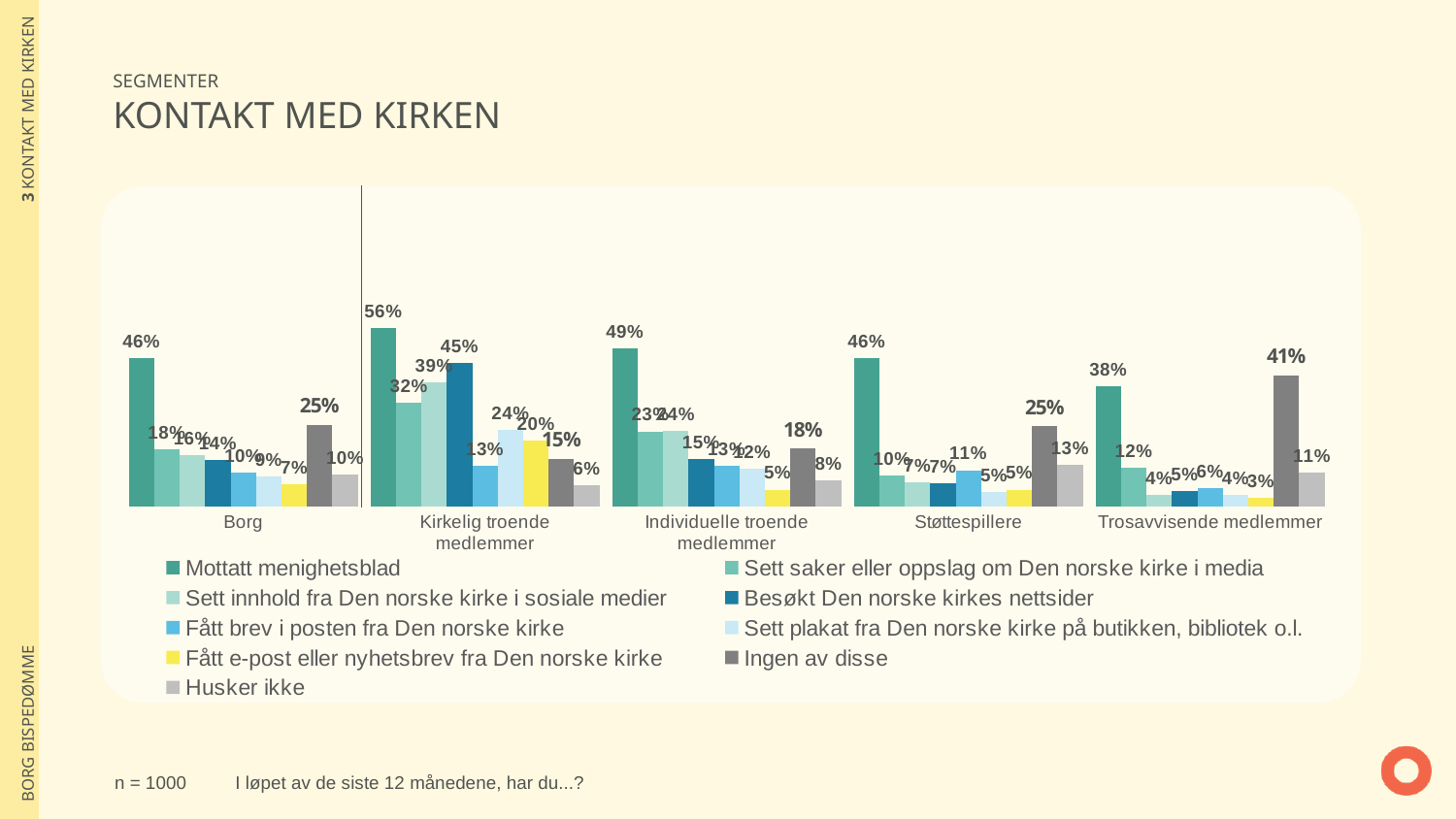
How many series does the legend list? 9 What is the value for Mottatt menighetsblad in the Kirkelig troende medlemmer category? 56% What is the value for Ingen av disse in the Støttespillere category? 25% What is the value for Ingen av disse in the Trosavvisende medlemmer category? 41% In the Støttespillere category, which is larger: Ingen av disse or Husker ikke? Ingen av disse Which category has the highest value for Mottatt menighetsblad? Kirkelig troende medlemmer What kind of chart is shown on the slide? Bar chart What is the difference between Mottatt menighetsblad for Kirkelig troende medlemmer (56%) and for Borg (46%)? 10 percentage points What is the value for Besøkt Den norske kirkes nettsider in the Kirkelig troende medlemmer category? 45% In the Trosavvisende medlemmer category, what is the difference between Ingen av disse (41%) and Mottatt menighetsblad (38%)? 3 percentage points How many categories are shown on the x axis? 5 Which category has the lowest value for Mottatt menighetsblad? Trosavvisende medlemmer